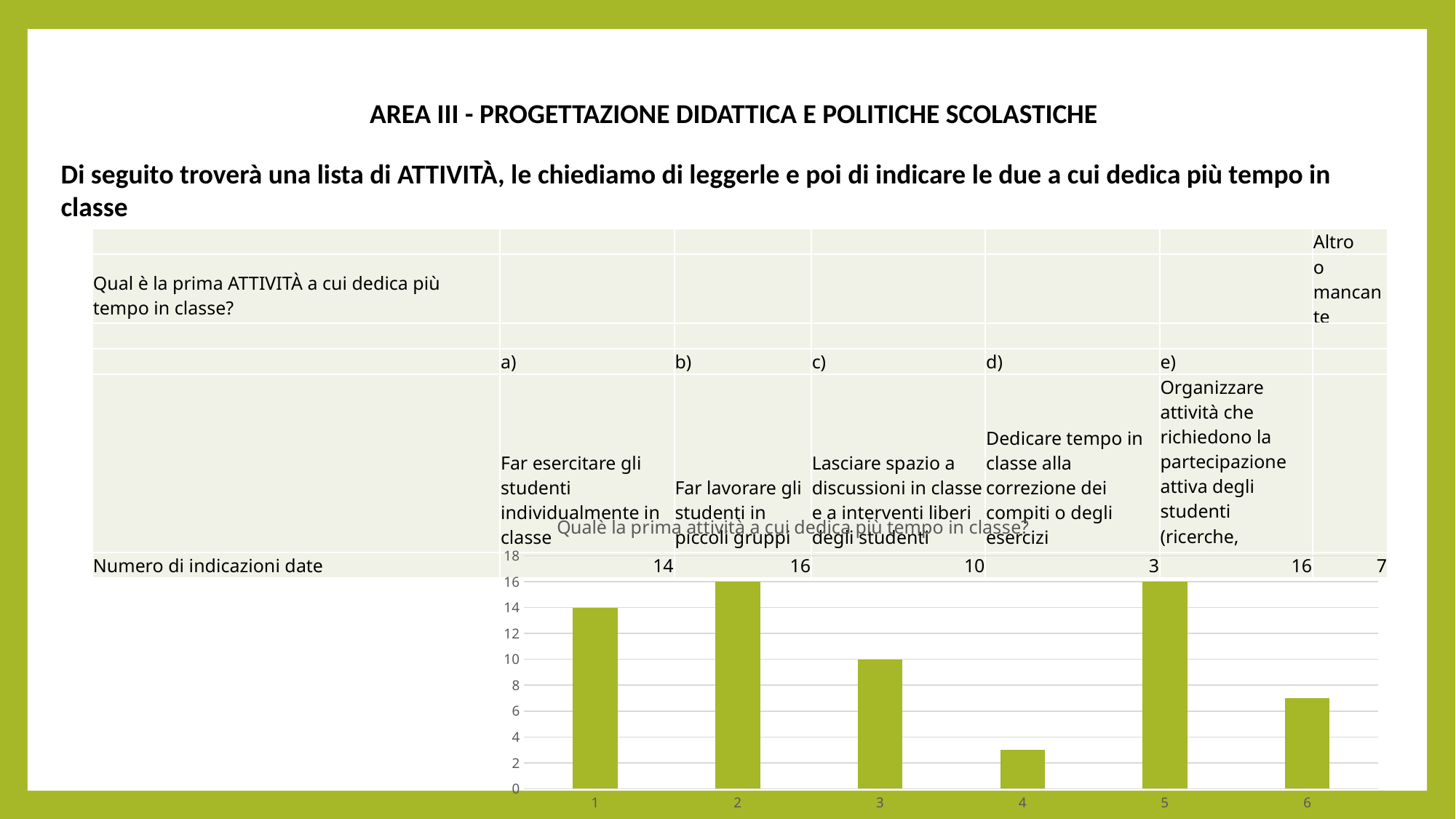
How many bars does the chart show? 6 What is the value of the bar for category 2? 16 What is the value of the bar for category 3? 10 What is the difference between the values for category 2 and category 1? 2 Is the value for category 6 greater or less than 8? less Which bar is taller, category 1 or category 3? category 1 What is the value of the bar for category 1? 14 What is the highest value shown on the vertical axis? 18 Which category has the lowest bar? 4 What is the value of the bar for category 5? 16 Is the value for category 4 greater or less than 4? less What kind of chart is shown at the bottom of the slide? bar chart